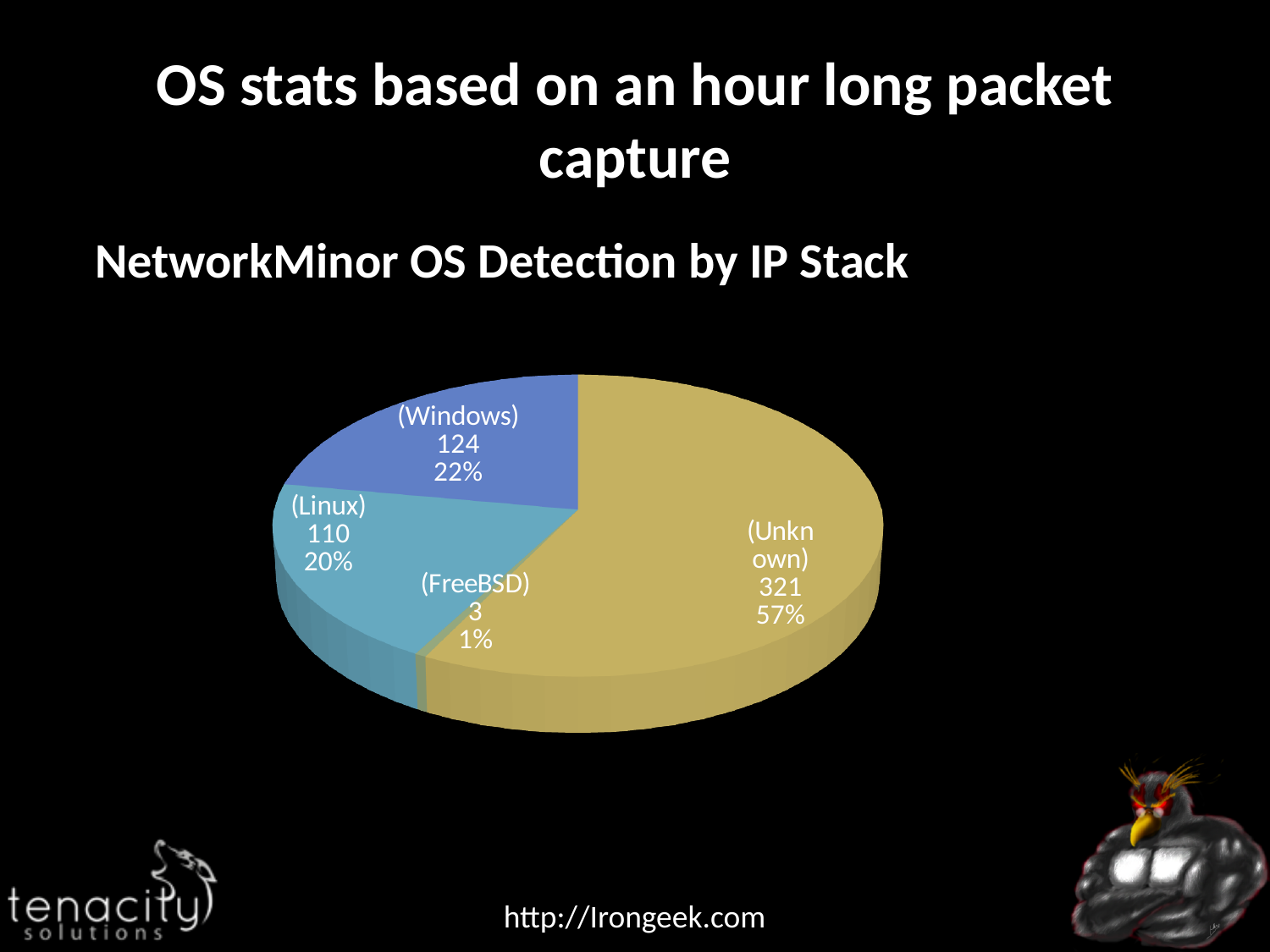
What share of the pie does (Unknown) represent? 57% Which category has the largest slice? (Unknown) What is the difference between the values for (Windows) and (Linux)? 14 What is the value for (Windows)? 124 Which category has the smallest slice? (FreeBSD) What is the value for (FreeBSD)? 3 How many slices does the pie chart have? 4 What is the chart's title? NetworkMinor OS Detection by IP Stack What is the value for (Unknown)? 321 What share of the pie does (Linux) represent? 20% What is the value for (Linux)? 110 What kind of chart is shown on the slide? pie chart